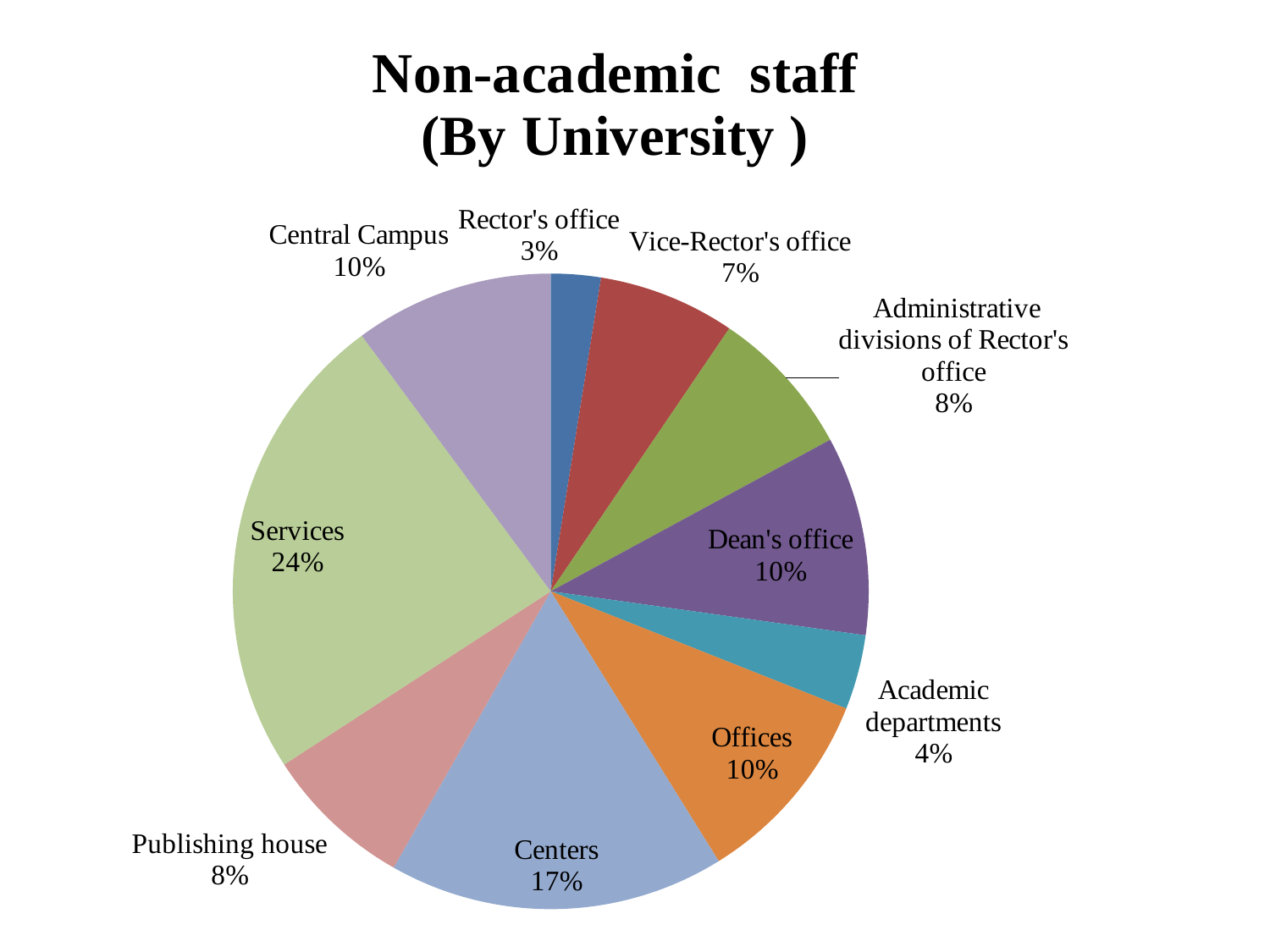
What share of non-academic staff is in Services? 24% What share does the Rector's office have? 3% Which category has the largest share of non-academic staff? Services Which category has the smallest share of non-academic staff? Rector's office What is the title of the chart? Non-academic staff (By University ) What percentage is shown for Academic departments? 4% How many categories does the pie chart show? 10 What kind of chart is shown on the slide? Pie chart What share is shown for Administrative divisions of Rector's office? 8% What is the difference in percentage points between Services and Centers? 7 Which is larger, the share for Vice-Rector's office or the share for Dean's office? Dean's office What percentage of non-academic staff is in Centers? 17%